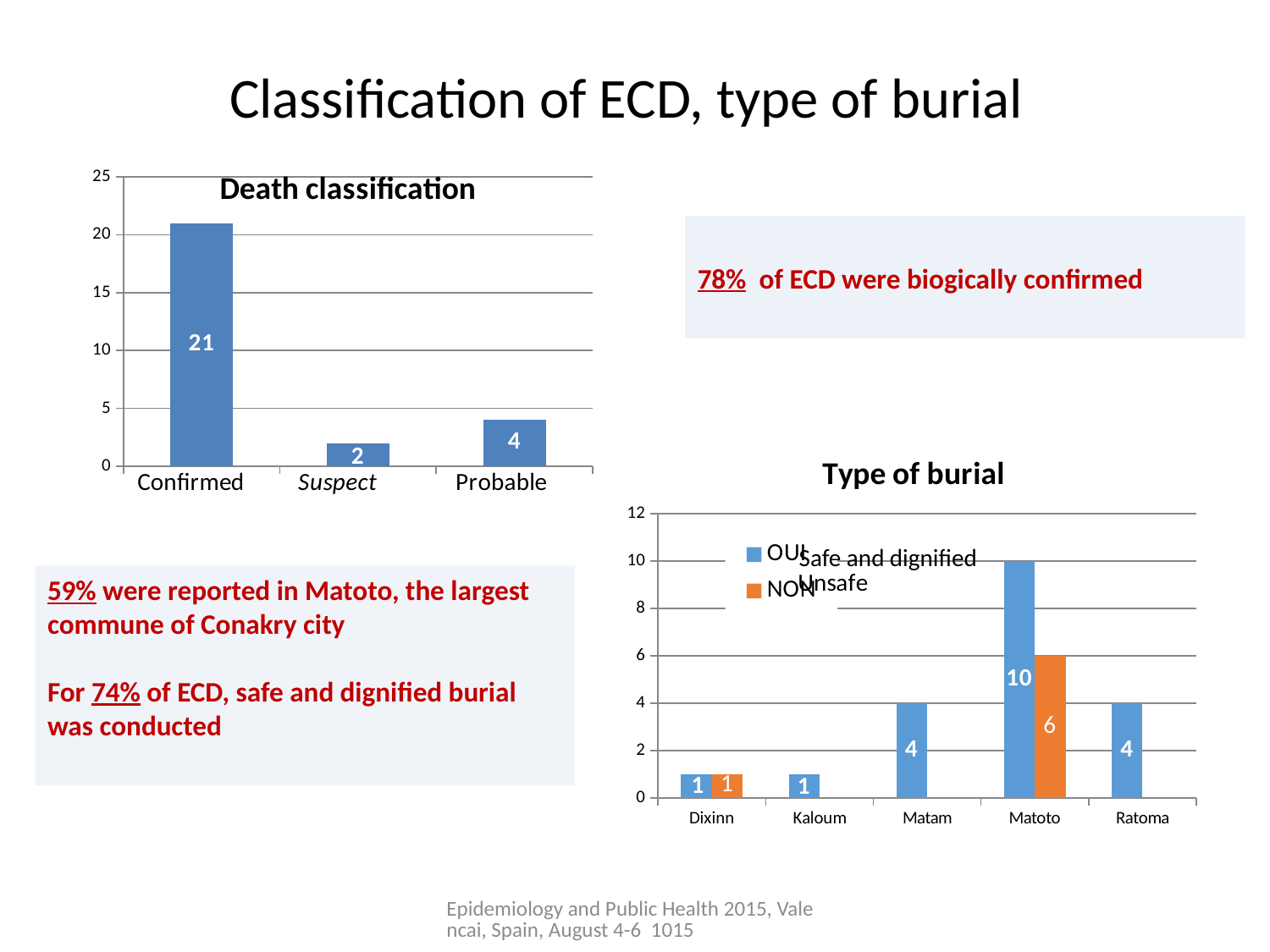
In the Death classification chart, which category has the lowest value? Suspect In the Death classification chart, which category has the highest value? Confirmed What kind of chart is the Type of burial chart? Bar chart In the Death classification chart, what is the difference between the Confirmed and Probable values? 17 In the Type of burial chart, which commune has the highest blue bar? Matoto In the Type of burial chart, which is larger, the blue bar for Matam or the blue bar for Kaloum? Matam In the Death classification chart, what is the value for Confirmed? 21 In the Type of burial chart, what is the value of the blue bar for Matoto? 10 In the Death classification chart, what is the value for Probable? 4 In the Death classification chart, how many categories are shown on the x axis? 3 In the Type of burial chart, how many communes are shown on the x axis? 5 In the Type of burial chart, what is the value of the orange bar for Matoto? 6